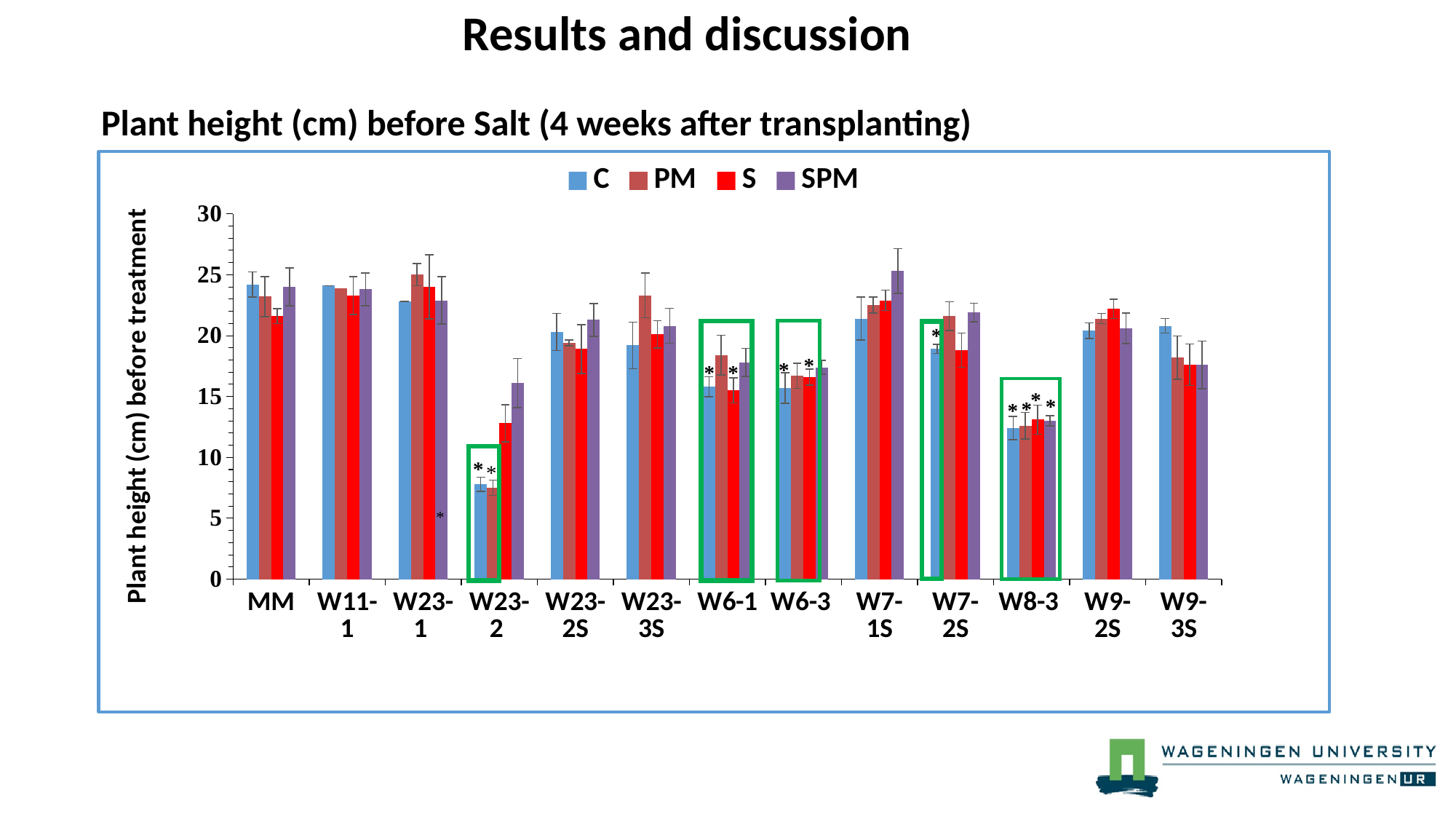
Is the value of the SPM bar for W7-1S greater or less than 20? greater How many series does the legend list? 4 How many categories are shown along the x axis? 13 Within the W23-2 category, which is larger, the C bar or the SPM bar? SPM Is the value of the C bar for W23-2 greater or less than 10? less What colour represents the S series in the legend? red What kind of chart is shown on the slide? bar chart Which category has the lowest C bar? W23-2 Which is larger, the C bar for W23-2 or the C bar for W8-3? W8-3 Is the value of the S bar for W6-1 greater or less than 20? less